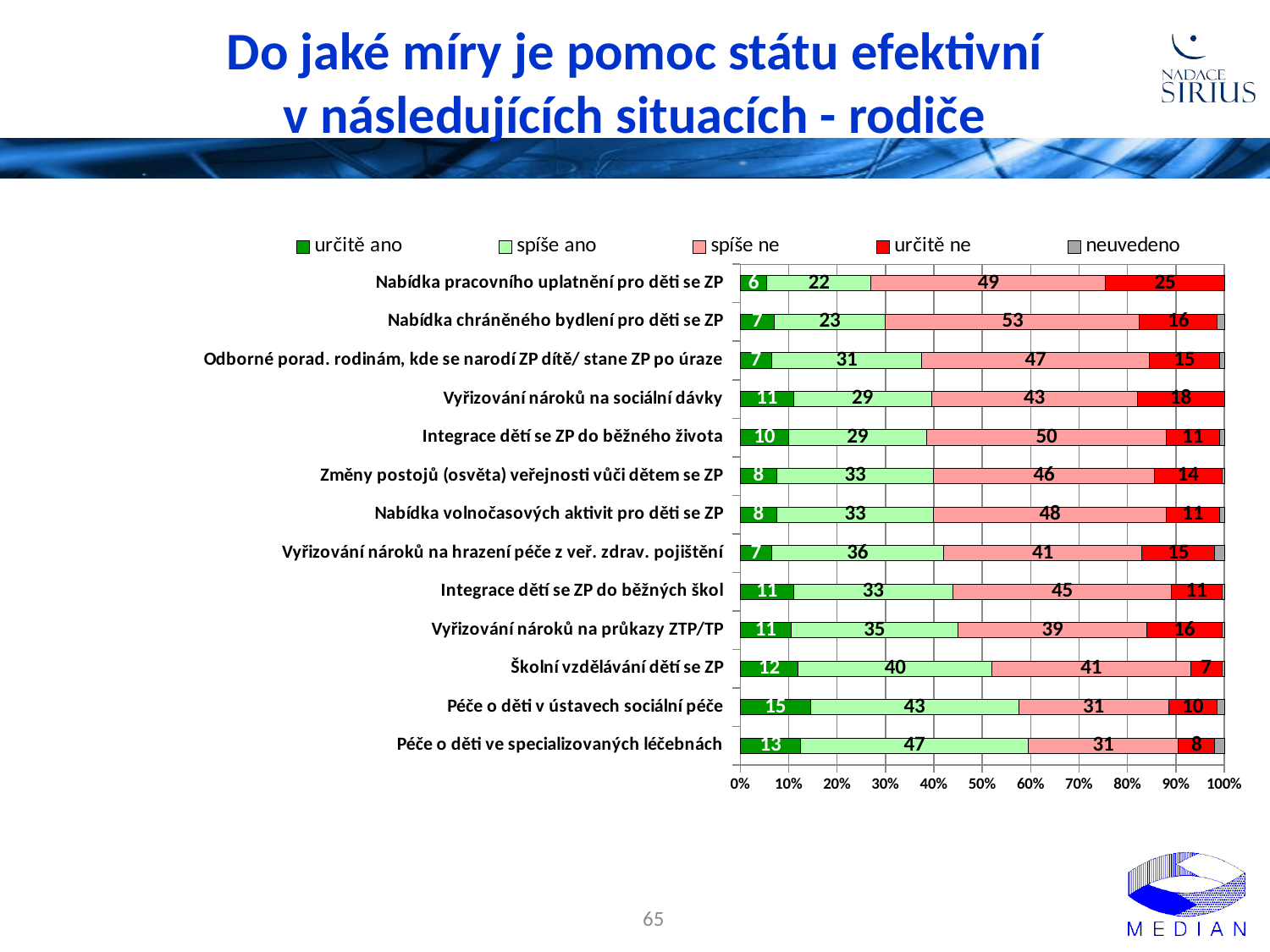
Which category has the highest 'určitě ne' value? Nabídka pracovního uplatnění pro děti se ZP How many series does the legend list? 5 Which category has the highest 'určitě ano' value? Péče o děti v ústavech sociální péče What is the value of 'spíše ne' for 'Nabídka chráněného bydlení pro děti se ZP'? 53 What is the value of 'určitě ano' for 'Školní vzdělávání dětí se ZP'? 12 What kind of chart is shown on the slide? Stacked bar chart What is the difference between the 'spíše ne' values for 'Nabídka chráněného bydlení pro děti se ZP' and 'Péče o děti v ústavech sociální péče'? 22 How many categories (situations) are shown in the chart? 13 Which category has the lowest 'určitě ano' value? Nabídka pracovního uplatnění pro děti se ZP Which is larger: the 'spíše ano' value for 'Školní vzdělávání dětí se ZP' or for 'Vyřizování nároků na průkazy ZTP/TP'? Školní vzdělávání dětí se ZP What is the value of 'určitě ne' for 'Nabídka pracovního uplatnění pro děti se ZP'? 25 What is the value of 'spíše ano' for 'Péče o děti ve specializovaných léčebnách'? 47